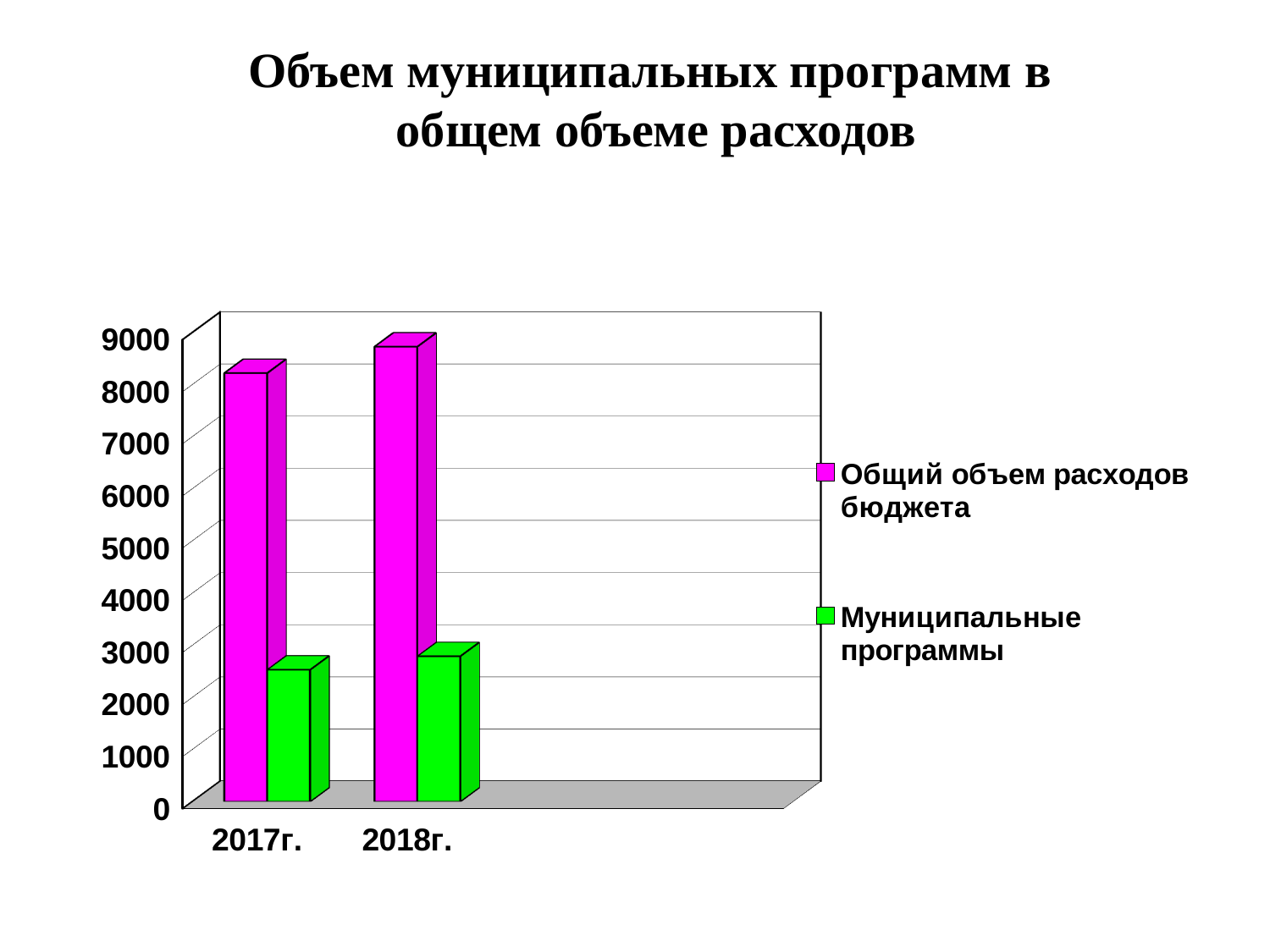
Is the value for Муниципальные программы in 2017г. greater or less than 3000? less How many categories (years) are shown on the x axis? 2 Is the value for Муниципальные программы in 2018г. greater or less than 2000? greater What is the title of the chart? Объем муниципальных программ в общем объеме расходов Is the value for Общий объем расходов бюджета in 2018г. greater or less than 8000? greater In 2018г., which series has the larger value? Общий объем расходов бюджета Does the value for Общий объем расходов бюджета rise or fall from 2017г. to 2018г.? rise How many series does the legend list? 2 Which series is shown in magenta? Общий объем расходов бюджета Which year has the higher value for Общий объем расходов бюджета, 2017г. or 2018г.? 2018г. What kind of chart is shown on the slide? bar chart